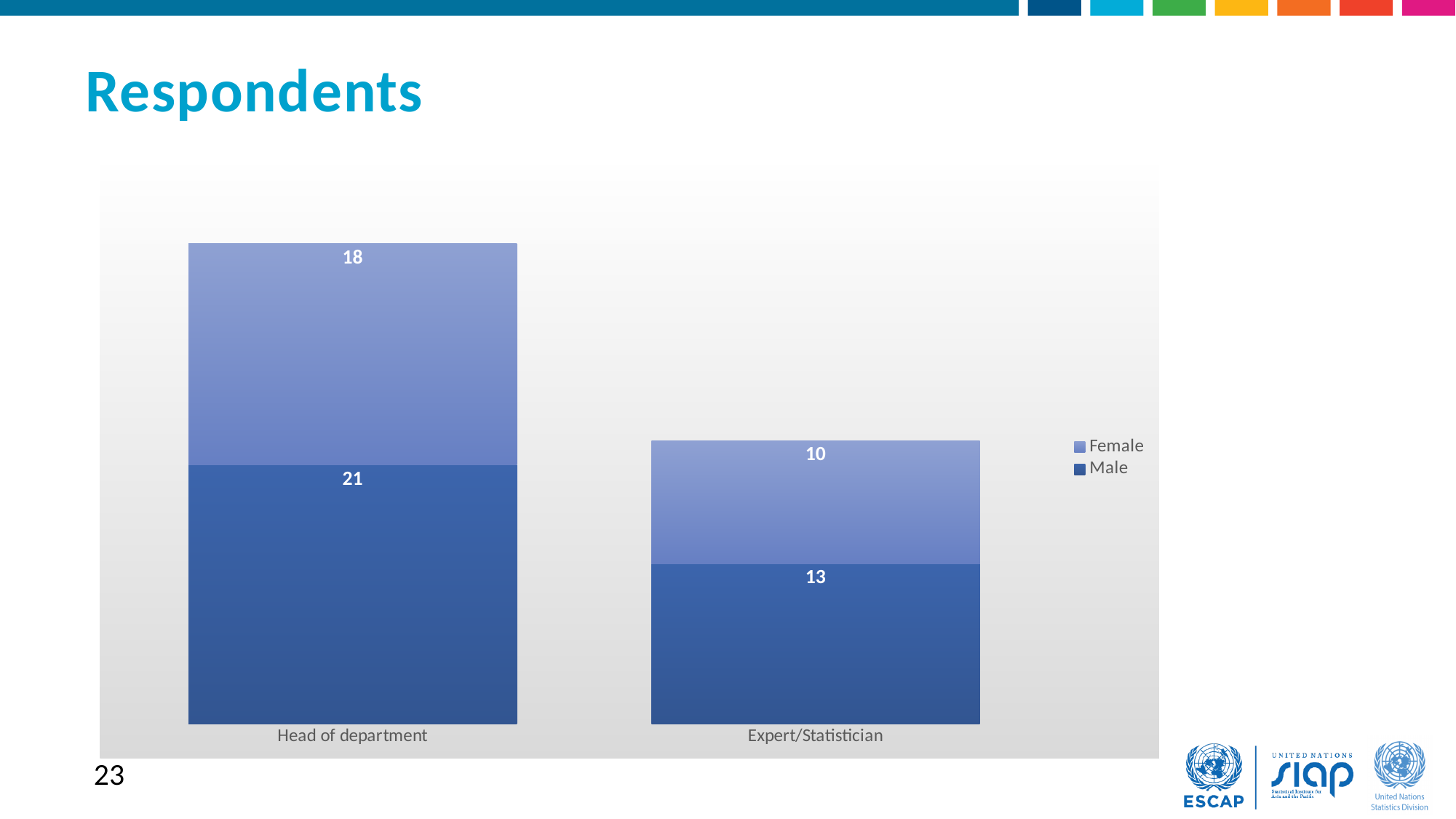
Which category has the higher Female value, Head of department or Expert/Statistician? Head of department What is the Female value for Head of department? 18 What is the difference between the Female values for Head of department and Expert/Statistician? 8 How many series does the legend list? 2 What is the Male value for Expert/Statistician? 13 What is the Female value for Expert/Statistician? 10 What is the total of the stacked bar for Expert/Statistician? 23 What is the difference between the Male values for Head of department and Expert/Statistician? 8 What is the Male value for Head of department? 21 How many categories are shown on the x axis? 2 What is the total of the stacked bar for Head of department? 39 What kind of chart is shown on the slide? Stacked bar chart